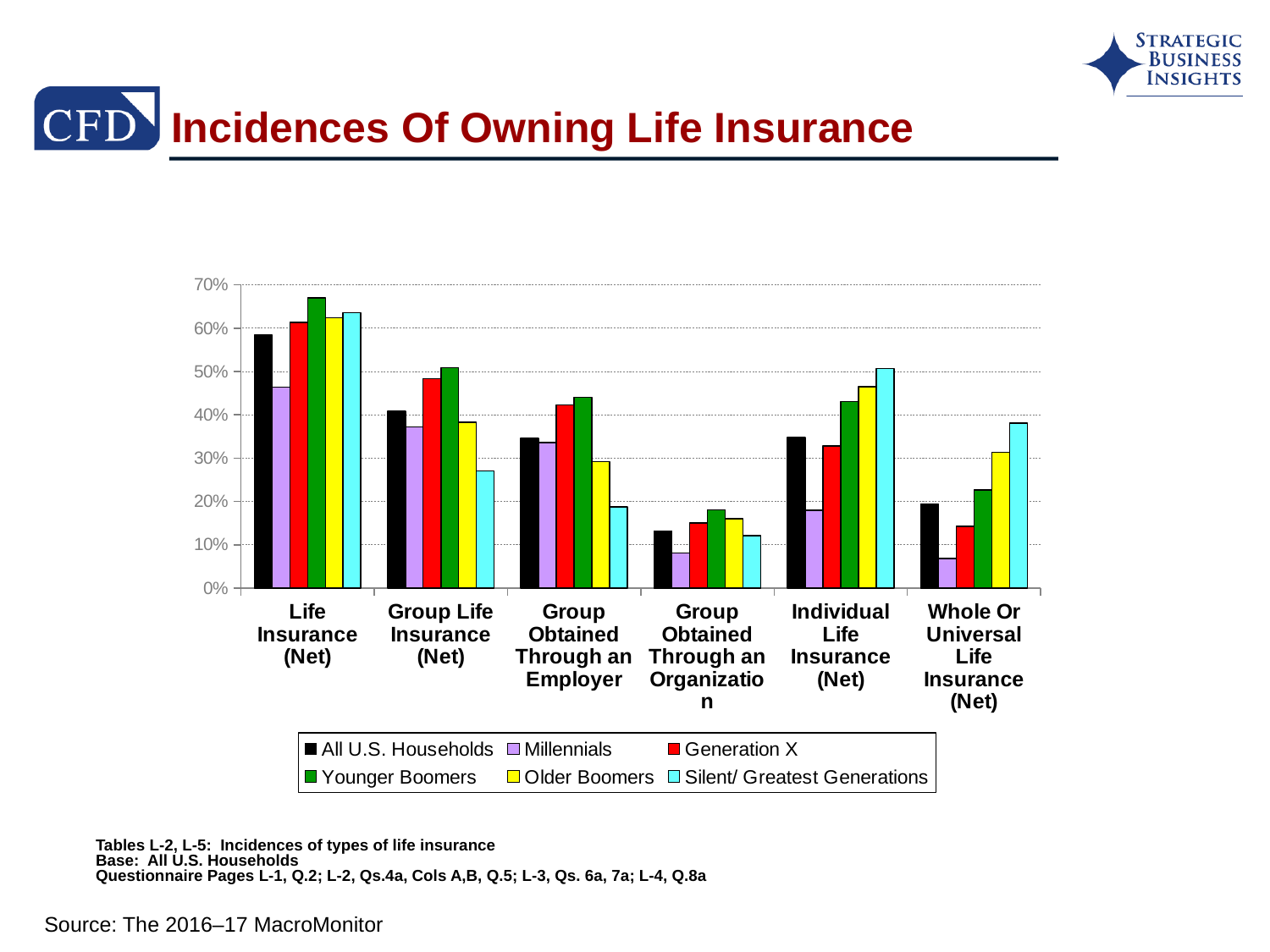
How many insurance categories are shown along the x axis? 6 Is the value for Millennials in Life Insurance (Net) greater or less than 50%? less How many series does the legend list? 6 Is the value for Younger Boomers in Group Life Insurance (Net) greater or less than 40%? greater In which category is the All U.S. Households value the lowest? Group Obtained Through an Organization Is the value for Silent/ Greatest Generations in Whole Or Universal Life Insurance (Net) greater or less than 30%? greater What kind of chart is shown on the slide? bar chart What colour represents Generation X in the legend? red For Whole Or Universal Life Insurance (Net), which series has the highest value? Silent/ Greatest Generations For Group Obtained Through an Employer, which is larger: Younger Boomers or Silent/ Greatest Generations? Younger Boomers For Life Insurance (Net), which series has the highest value? Younger Boomers For Individual Life Insurance (Net), which series has the lowest value? Millennials